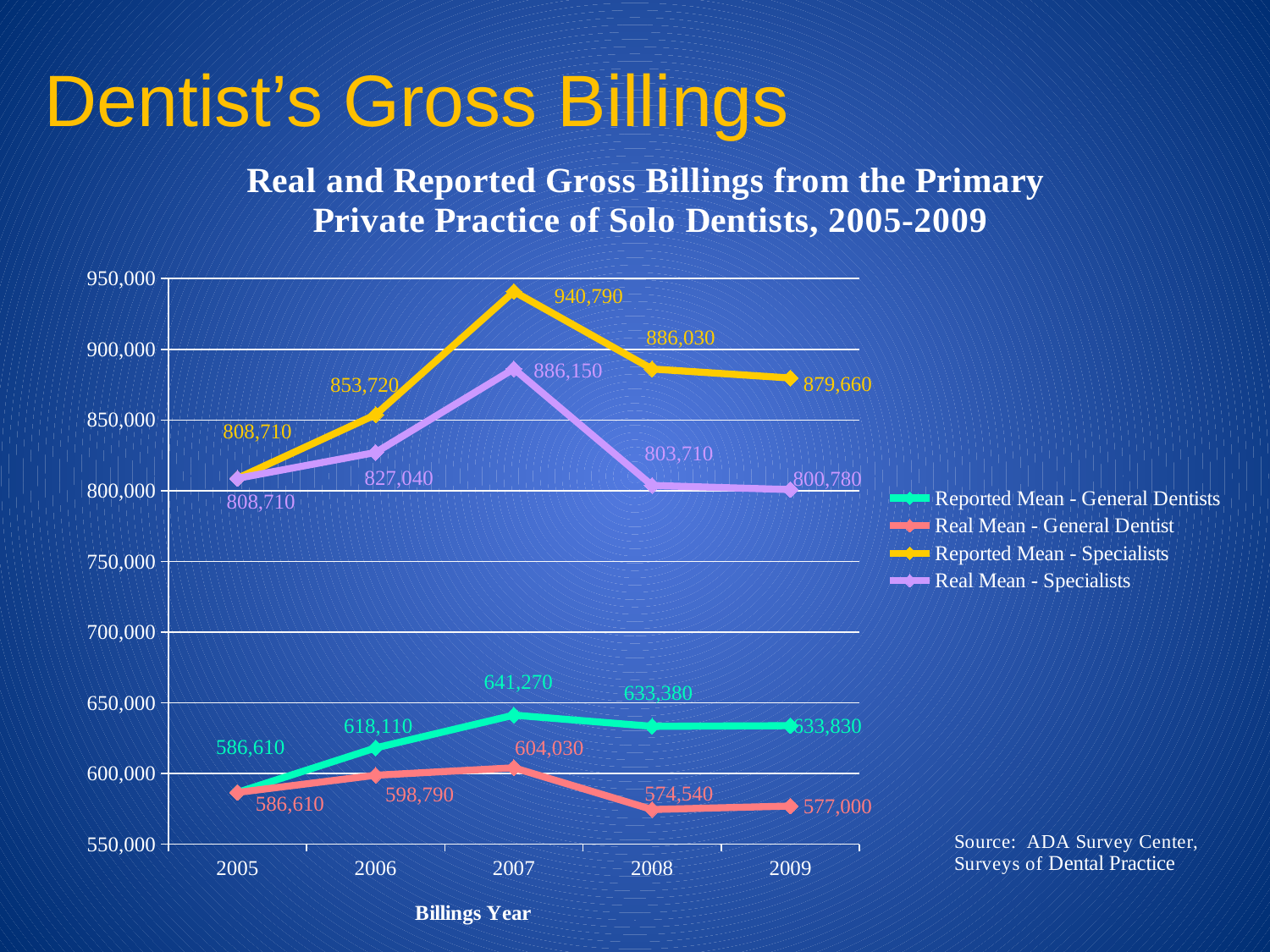
What kind of chart is shown on the slide? Line chart How many years are shown on the x axis? 5 What is the Real Mean - General Dentist value for 2008? 574,540 In which year is the Reported Mean - Specialists highest? 2007 In which year is the Real Mean - General Dentist lowest? 2008 How many series does the legend list? 4 Does the Real Mean - Specialists rise or fall from 2007 to 2008? Fall Which is larger in 2006: the Reported Mean - General Dentists or the Real Mean - General Dentist? Reported Mean - General Dentists What is the Reported Mean - Specialists value for 2007? 940,790 What is the Reported Mean - General Dentists value for 2009? 633,830 What is the difference between the Reported Mean - Specialists and the Real Mean - Specialists in 2009? 78,880 What is the Real Mean - Specialists value for 2006? 827,040